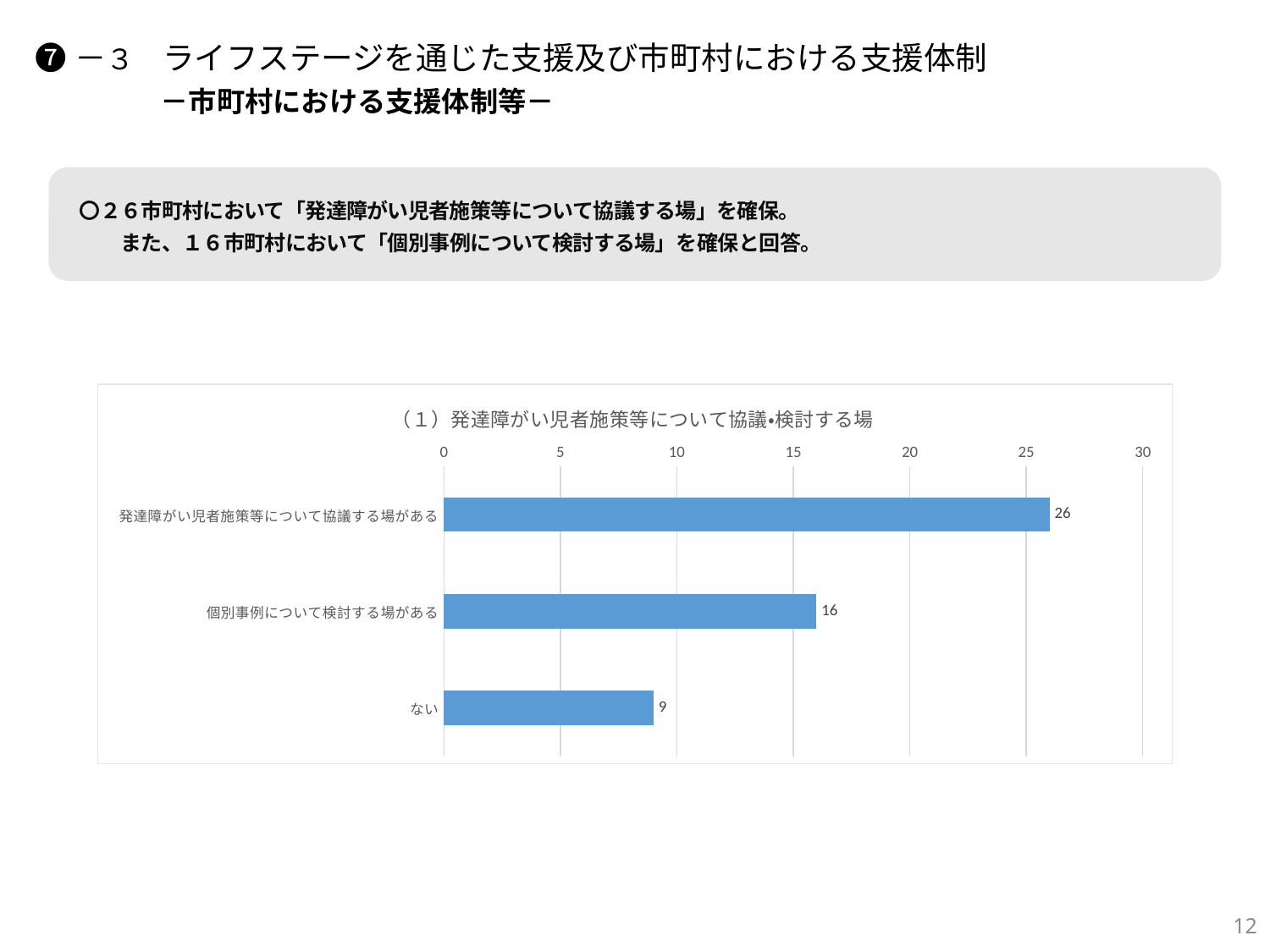
What kind of chart is shown on the slide? bar chart How many categories are shown in the chart? 3 What is the difference between the values for 発達障がい児者施策等について協議する場がある and 個別事例について検討する場がある? 10 What is the value for ない? 9 Which category has the highest value? 発達障がい児者施策等について協議する場がある What is the title of the chart? （１）発達障がい児者施策等について協議•検討する場 Which is larger, the value for 個別事例について検討する場がある or the value for ない? 個別事例について検討する場がある What is the difference between the values for 個別事例について検討する場がある and ない? 7 Which category has the lowest value? ない What is the value for 発達障がい児者施策等について協議する場がある? 26 Is the value for ない greater or less than 10? less What is the value for 個別事例について検討する場がある? 16